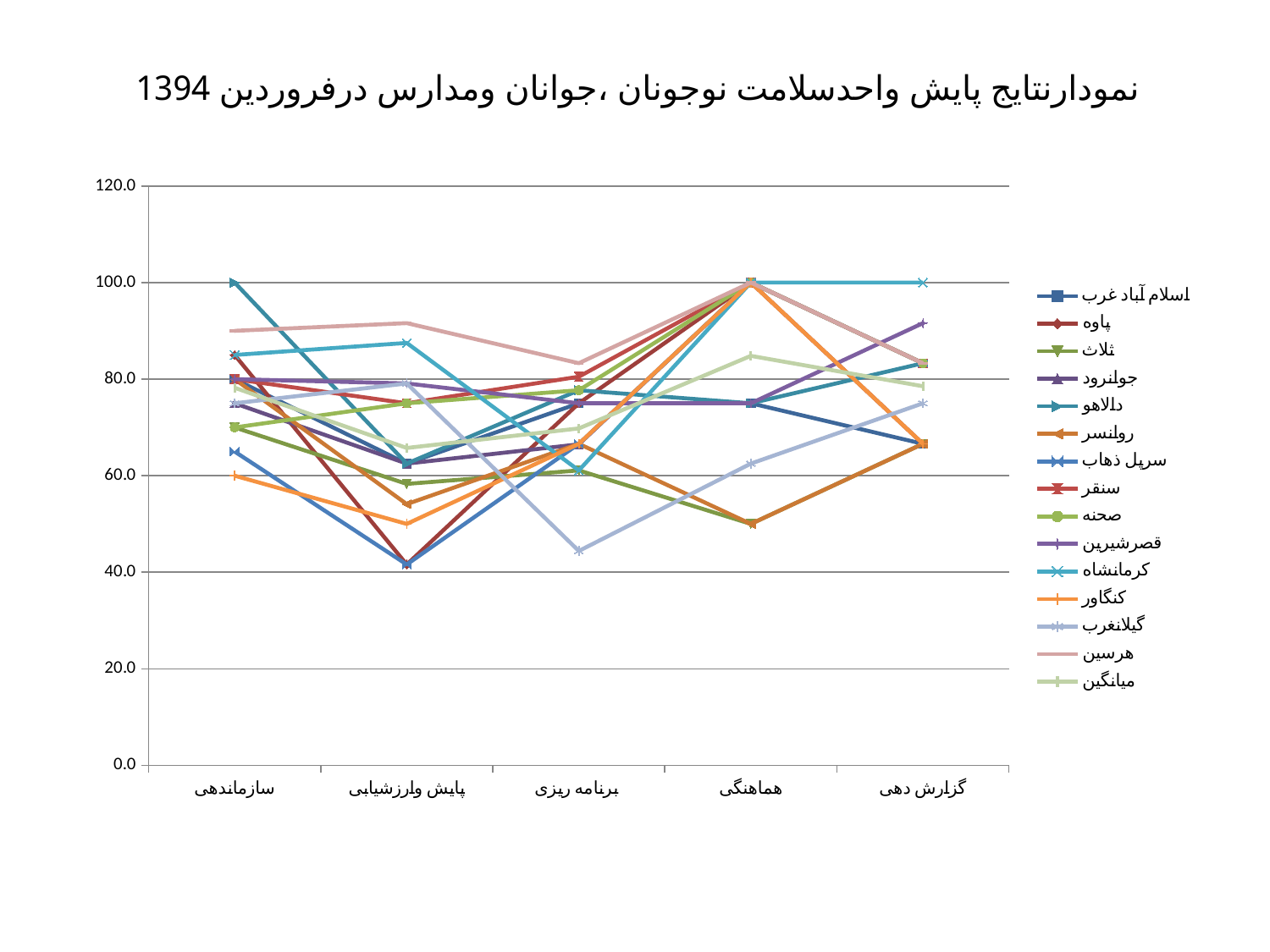
Does the value for میانگین rise or fall from سازماندهی to پایش وارزشیابی? fall What kind of chart is shown on the slide? line chart Which series has the lowest value at برنامه ریزی? گیلانغرب Is the value for هرسین at سازماندهی greater or less than 80? greater Which series has the highest value at گزارش دهی? کرمانشاه Is the value for گیلانغرب at برنامه ریزی greater or less than 60? less At سازماندهی, which is larger: the value for هرسین or the value for کنگاور? هرسین How many categories are shown on the x axis? 5 How many series does the legend list? 15 What is the value for کرمانشاه at گزارش دهی? 100.0 What is the value for دالاهو at سازماندهی? 100.0 What is the value for کنگاور at سازماندهی? 60.0